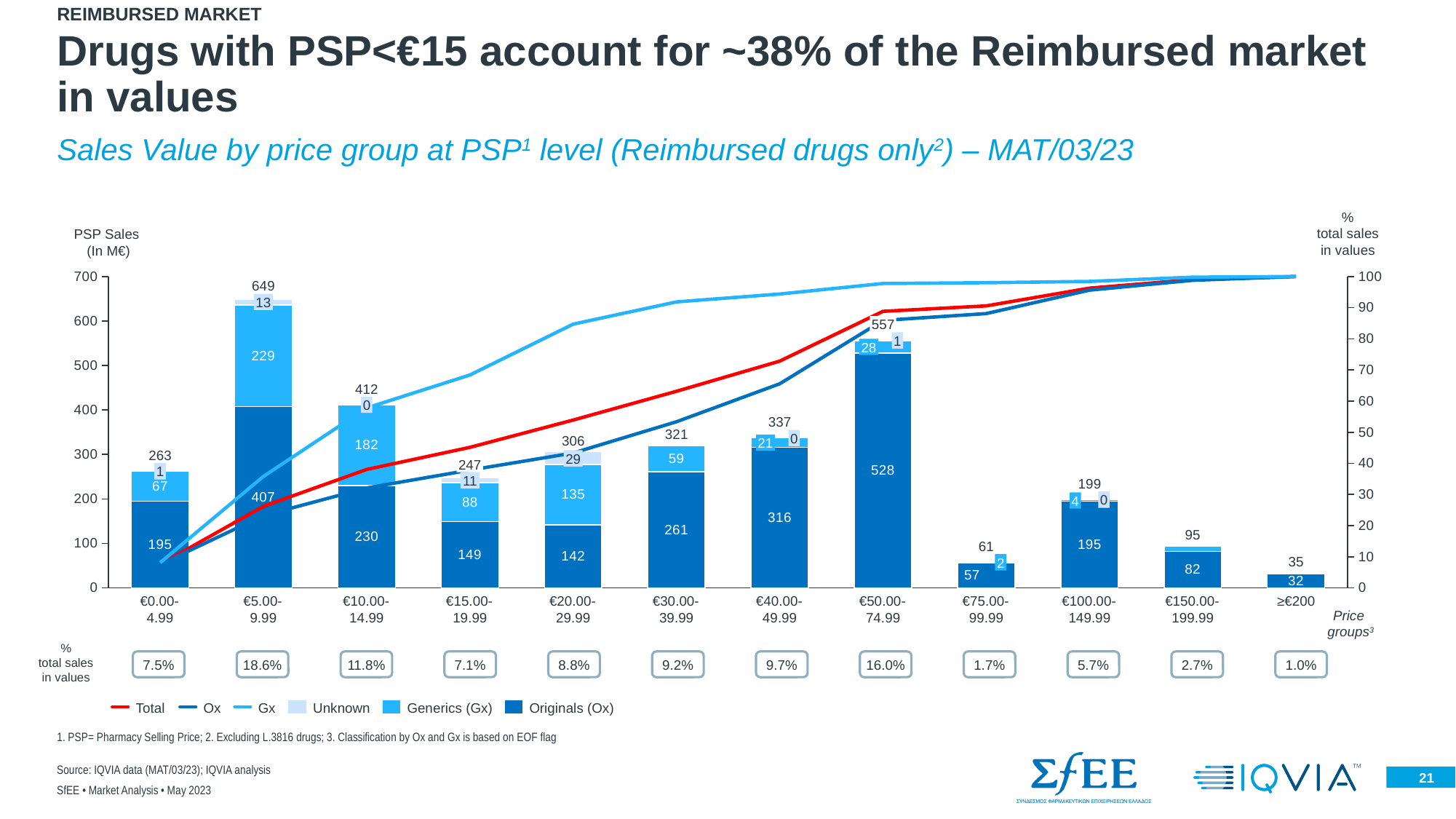
What is the Originals (Ox) value for the €5.00-9.99 price group? 407 Which price group has the lowest total PSP sales? ≥€200 How many entries does the legend list? 6 Which price group has the highest total PSP sales? €5.00-9.99 How many price groups are shown on the x axis? 12 What is the unit shown for the left-hand axis of the chart? M€ What kind of chart is used to show PSP sales by price group? bar chart Which has higher total PSP sales: the €30.00-39.99 group or the €20.00-29.99 group? €30.00-39.99 What percentage of total sales in values does the €50.00-74.99 price group account for? 16.0% What is the Generics (Gx) value for the €10.00-14.99 price group? 182 What is the difference between the total PSP sales of the €5.00-9.99 group and the €50.00-74.99 group? 92 What is the total PSP sales value of the stacked bar for the €15.00-19.99 price group? 247